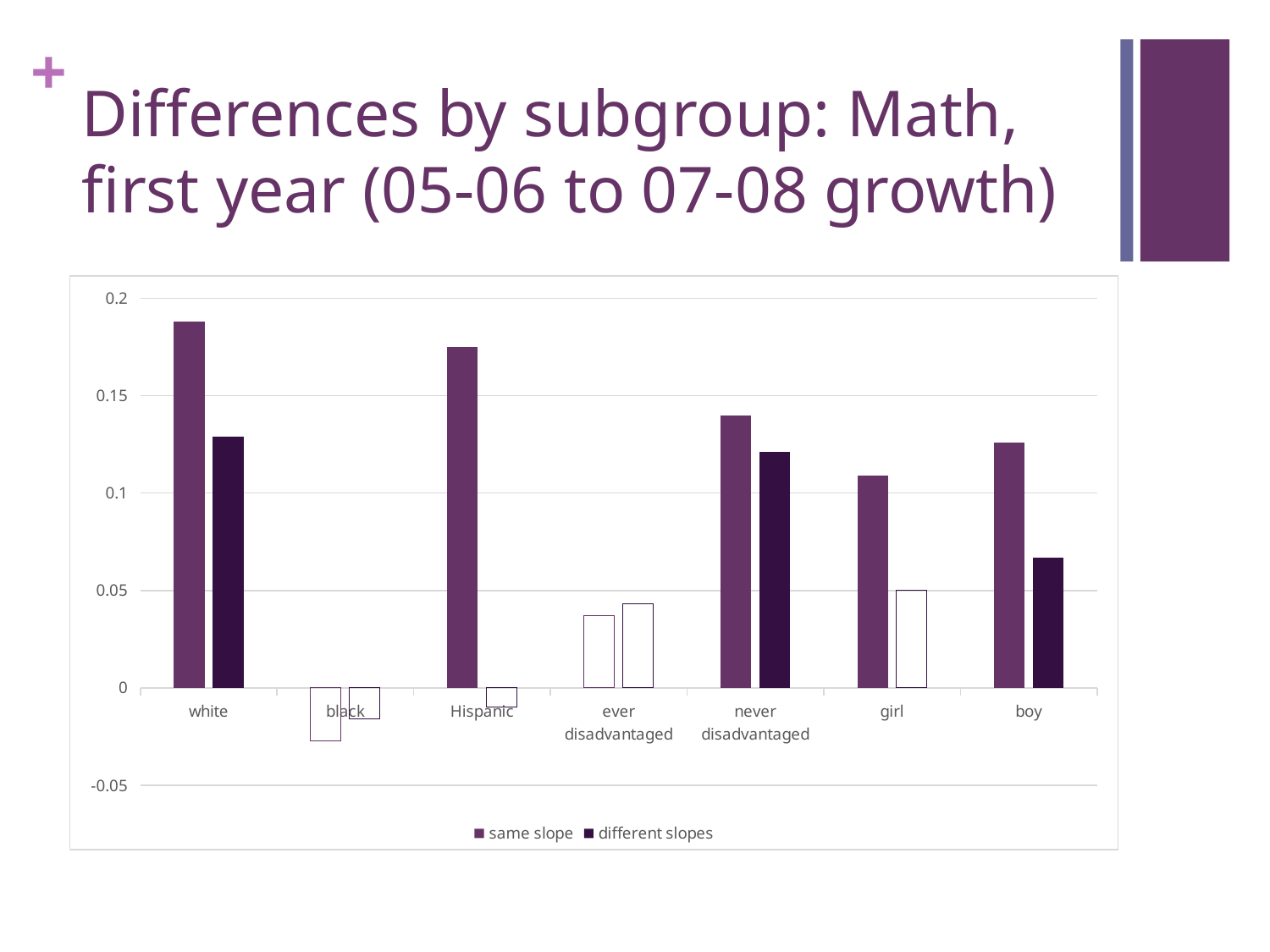
Is the 'different slopes' value for Hispanic greater or less than 0? less Is the 'different slopes' value for boy greater or less than 0.05? greater What are the two series named in the chart's legend? same slope, different slopes How many series does the chart's legend list? 2 Which category has the lowest 'different slopes' value? black Is the 'same slope' value for white greater or less than 0.15? greater Which category has the lowest 'same slope' value? black How many subgroup categories are shown on the x axis of the chart? 7 For boy, which series has the larger value, 'same slope' or 'different slopes'? same slope Which category has the highest 'same slope' value? white What kind of chart is shown on the slide? bar chart For Hispanic, which series has the larger value, 'same slope' or 'different slopes'? same slope